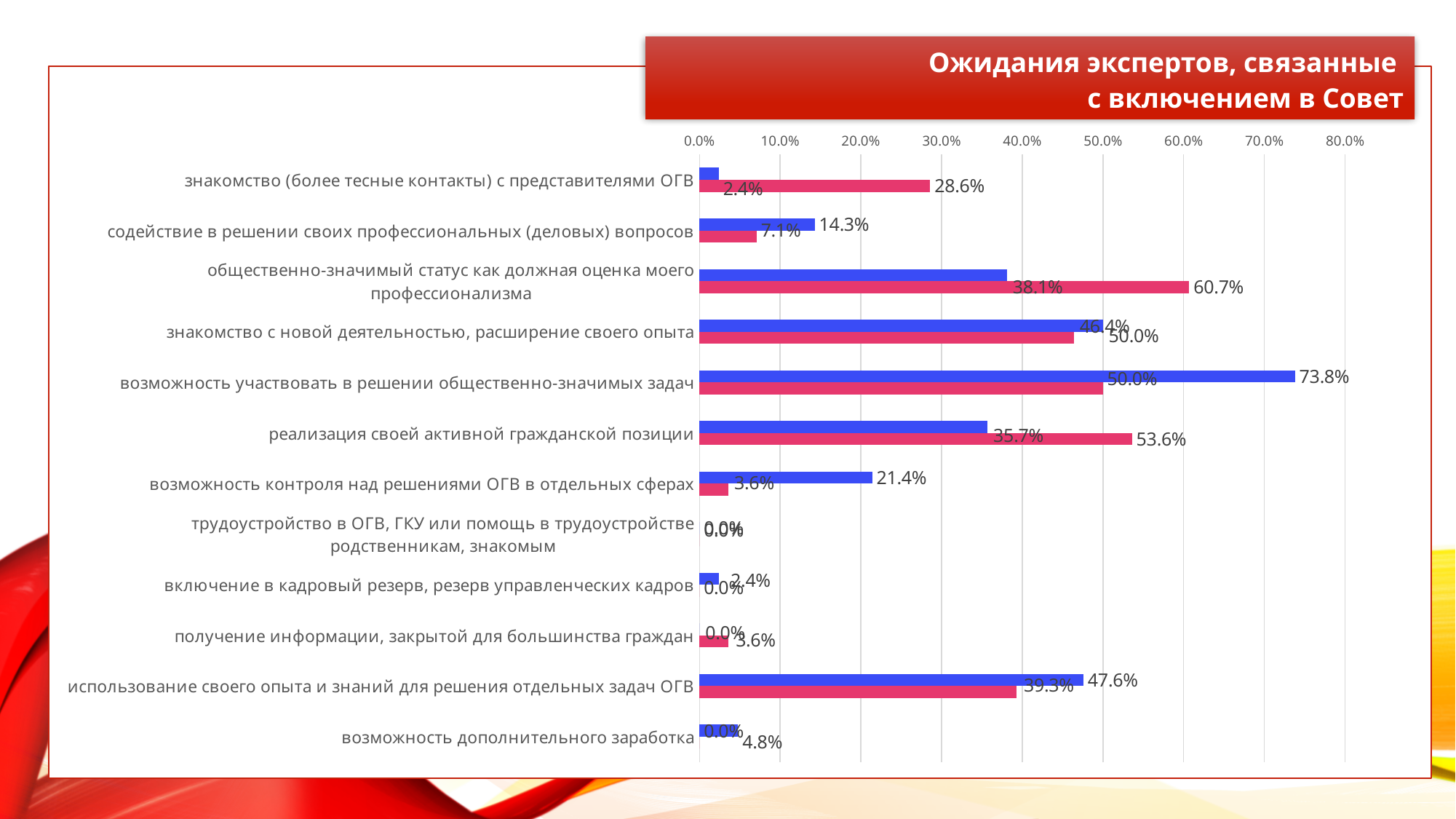
What is the value of the blue bar for "возможность участвовать в решении общественно-значимых задач"? 73.8% What kind of chart is shown on the slide? bar chart What is the difference between the pink and blue bars for "реализация своей активной гражданской позиции"? 17.9% For "использование своего опыта и знаний для решения отдельных задач ОГВ", which bar is larger, blue or pink? blue Which category has the highest pink bar? общественно-значимый статус как должная оценка моего профессионализма What is the title of the chart? Ожидания экспертов, связанные с включением в Совет What is the value of the pink bar for "общественно-значимый статус как должная оценка моего профессионализма"? 60.7% What is the value of the pink bar for "знакомство (более тесные контакты) с представителями ОГВ"? 28.6% Is the blue bar for "общественно-значимый статус как должная оценка моего профессионализма" greater or less than 30.0%? greater How many categories are listed on the chart? 12 What is the value of the blue bar for "возможность контроля над решениями ОГВ в отдельных сферах"? 21.4% Which category has the highest blue bar? возможность участвовать в решении общественно-значимых задач